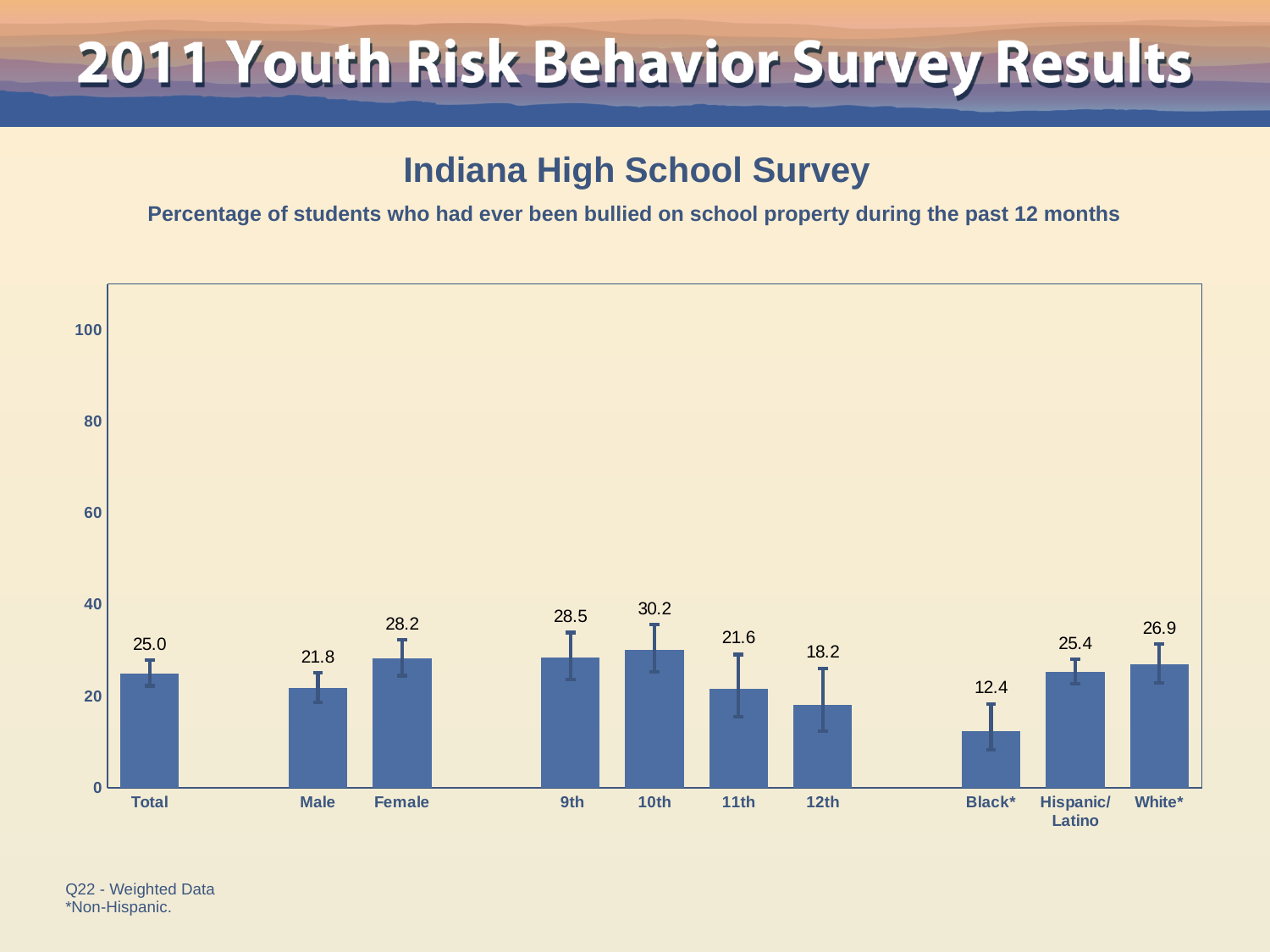
What is the value for Female? 28.2 Which category has the lowest value? Black* What is the value for Total? 25.0 What is the difference between the values for Female and Male? 6.4 How many categories are shown on the x axis? 10 Which is larger, the value for 9th or the value for 12th? 9th What kind of chart is shown? bar chart Which category has the highest value? 10th Is the value for 10th greater or less than 40? less What is the value for Black*? 12.4 Do the values rise or fall from 10th to 12th grade? fall What is the difference between the values for White* and Hispanic/Latino? 1.5